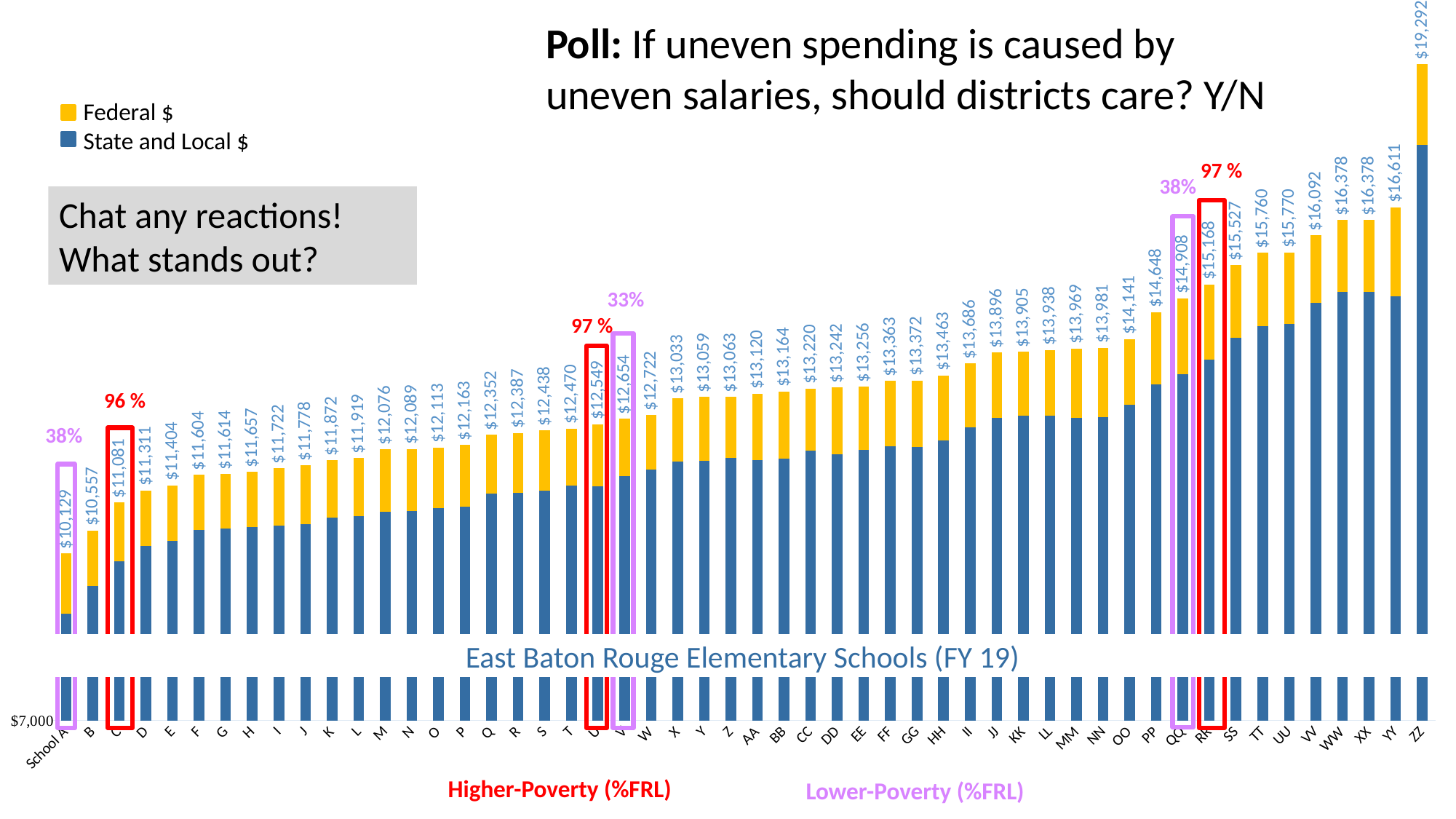
Which school has the lowest total spending in the chart? School A What is the value labeled for School RR? $15,168 Which has a larger total, School C or School QQ? QQ What is the total value labeled for School A? $10,129 Which colour represents Federal $ in the chart? Yellow What is the difference between the totals for School ZZ and School A? $9,163 What is the total per-pupil spending shown for School ZZ? $19,292 How many series does the legend list? 2 How many schools are plotted in the chart? 52 Which school has the highest total spending in the chart? ZZ What kind of chart is shown on the slide? Stacked bar chart What is the difference between the totals for School RR and School QQ? $260